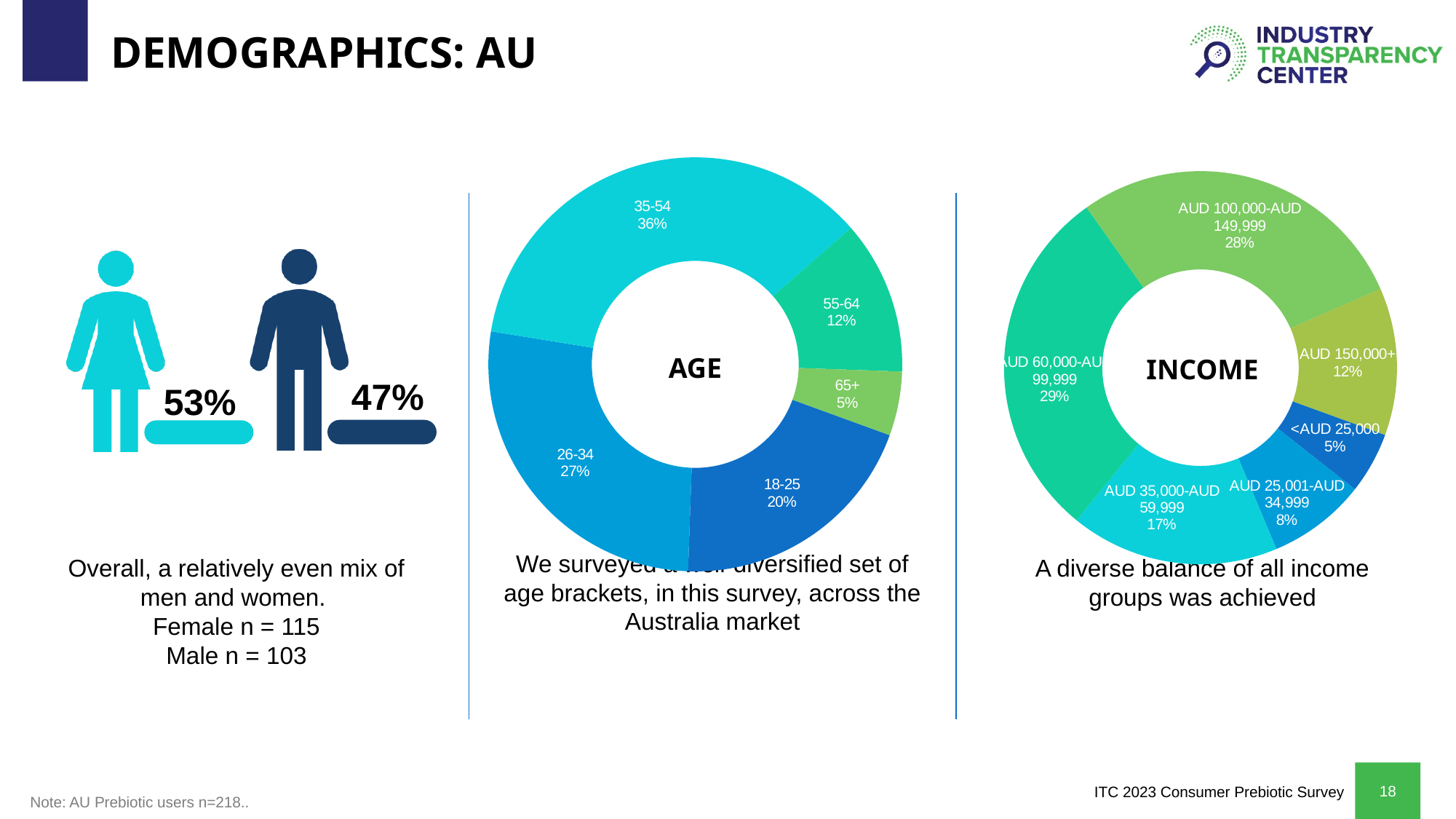
What kind of chart is the INCOME chart? Donut (pie) chart In the AGE chart, what share of respondents are aged 35-54? 36% How many income groups are shown in the INCOME chart? 6 In the AGE chart, which age bracket has the smallest share? 65+ In the AGE chart, which age bracket has the largest share? 35-54 How many age brackets are shown in the AGE chart? 5 In the INCOME chart, what share of respondents earn AUD 60,000-AUD 99,999? 29% In the INCOME chart, which is larger: the share for AUD 35,000-AUD 59,999 or the share for AUD 25,001-AUD 34,999? AUD 35,000-AUD 59,999 In the INCOME chart, what share of respondents earn AUD 150,000+? 12% In the INCOME chart, which income group has the smallest share? <AUD 25,000 In the AGE chart, what is the difference in percentage points between the 26-34 and 55-64 brackets? 15 In the AGE chart, what share of respondents are aged 18-25? 20%